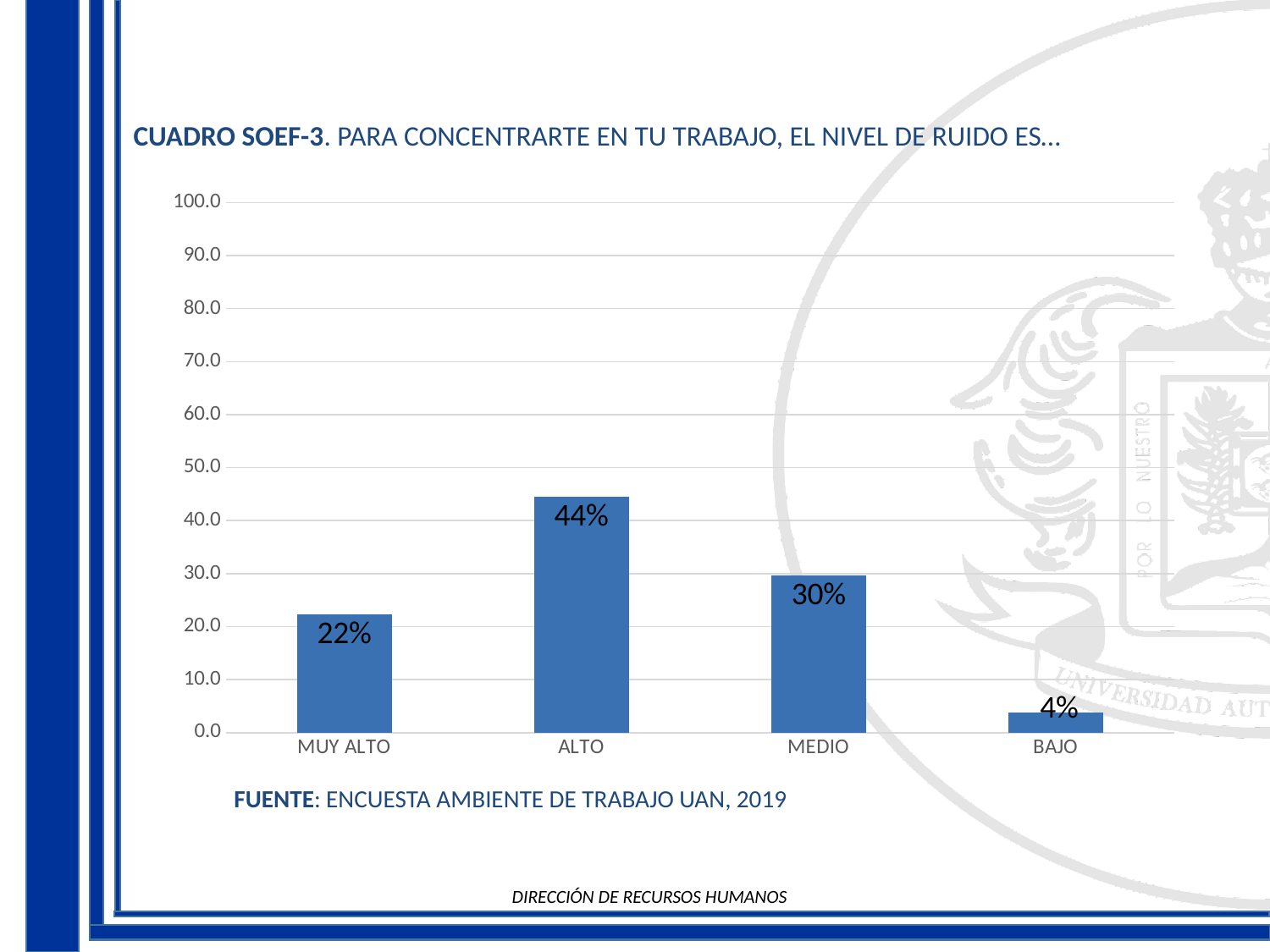
Which is larger, the value for MUY ALTO or the value for MEDIO? MEDIO Is the value for MEDIO greater or less than 40.0? less Which category has the lowest value? BAJO What is the difference between the values for MUY ALTO and BAJO? 18% What is the value for ALTO? 44% What is the difference between the values for ALTO and MEDIO? 14% Which category has the highest value? ALTO How many categories are shown on the x axis? 4 What kind of chart is shown on the slide? bar chart What is the value for MUY ALTO? 22% What is the value for BAJO? 4% What source is cited below the chart? ENCUESTA AMBIENTE DE TRABAJO UAN, 2019